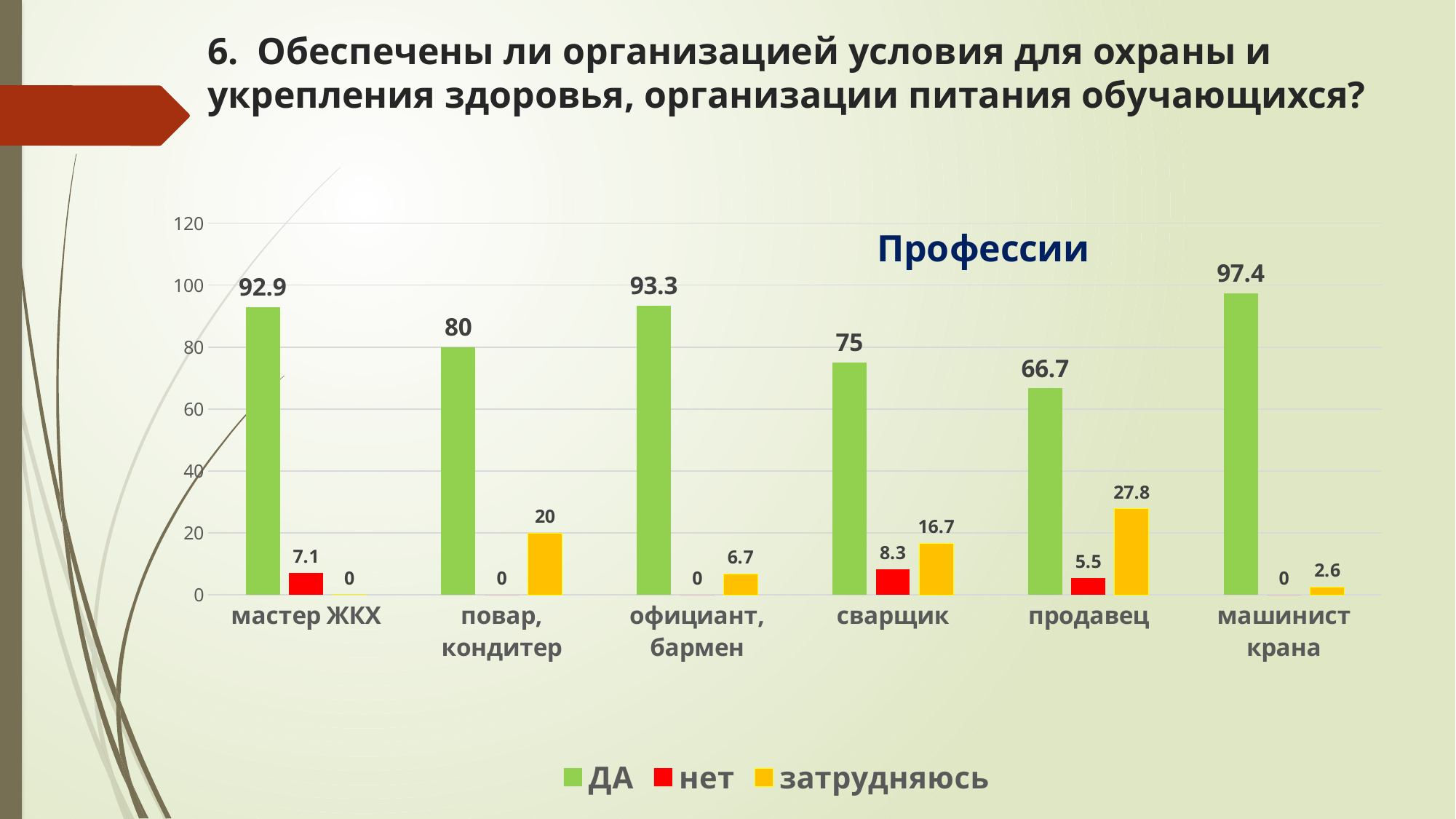
What is the value of нет for мастер ЖКХ? 7.1 What is the value of затрудняюсь for продавец? 27.8 Which category has the highest ДА value? машинист крана What kind of chart is shown on the slide? bar chart What is the difference between the ДА values for машинист крана and продавец? 30.7 Which category has the lowest ДА value? продавец How many categories are shown on the x axis? 6 How many series does the legend list? 3 Which is larger: the затрудняюсь value for повар, кондитер or for сварщик? повар, кондитер What is the value of ДА for сварщик? 75 What is the title shown on the chart? Профессии Which colour represents the нет series in the legend? red